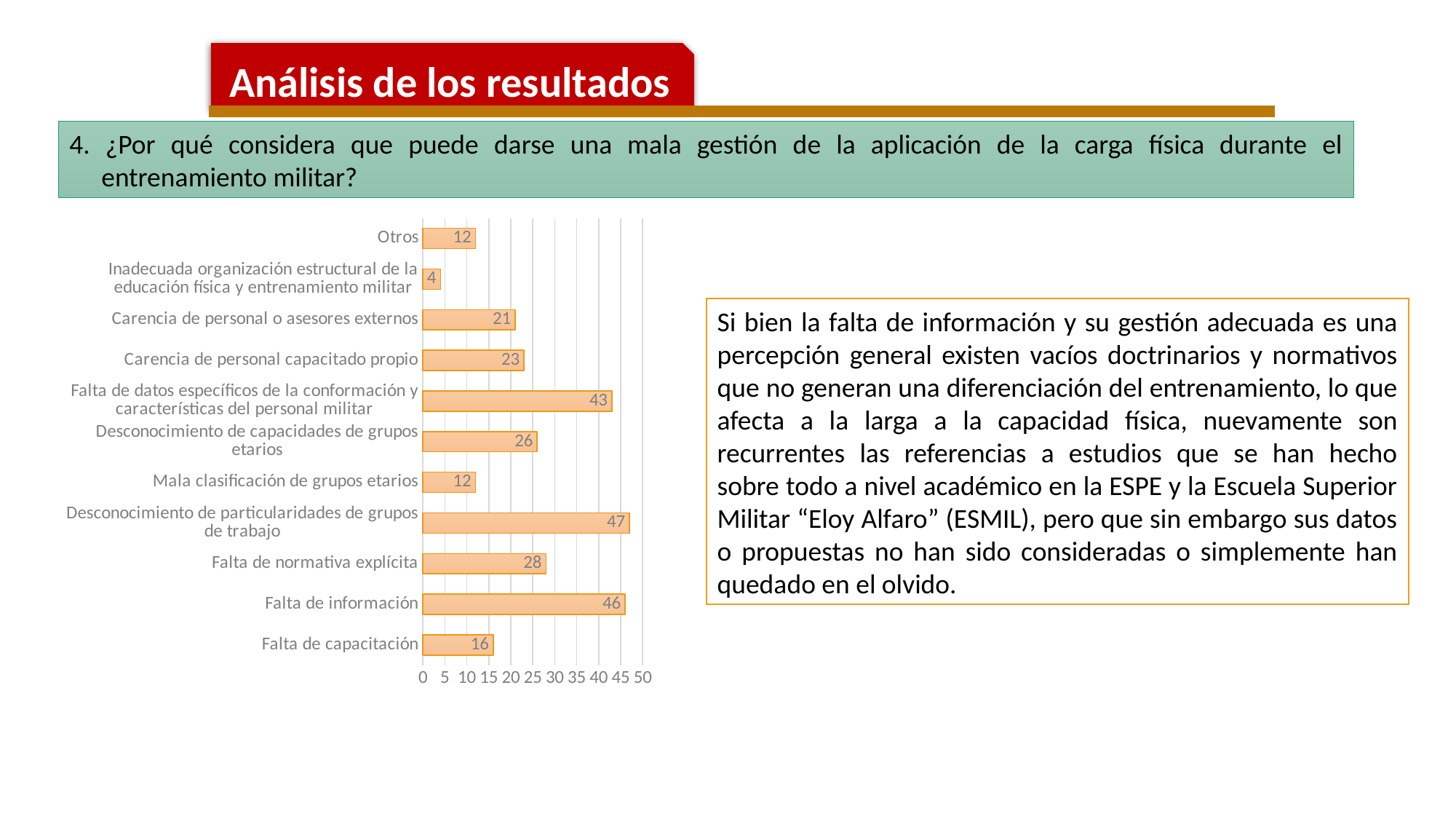
What is the value for "Falta de normativa explícita"? 28 What kind of chart is shown on the slide? bar chart How many categories are shown in the chart? 11 What is the value for "Carencia de personal capacitado propio"? 23 Is the value for "Falta de información" greater or less than 40? greater Which category has the highest value? Desconocimiento de particularidades de grupos de trabajo Which category has the lowest value? Inadecuada organización estructural de la educación física y entrenamiento militar What is the difference between the values for "Falta de datos específicos de la conformación y características del personal militar" and "Falta de capacitación"? 27 What is the difference between the values for "Desconocimiento de particularidades de grupos de trabajo" and "Falta de información"? 1 Which is larger, the value for "Desconocimiento de capacidades de grupos etarios" or the value for "Carencia de personal o asesores externos"? Desconocimiento de capacidades de grupos etarios What is the value for "Falta de información"? 46 What is the value for "Otros"? 12